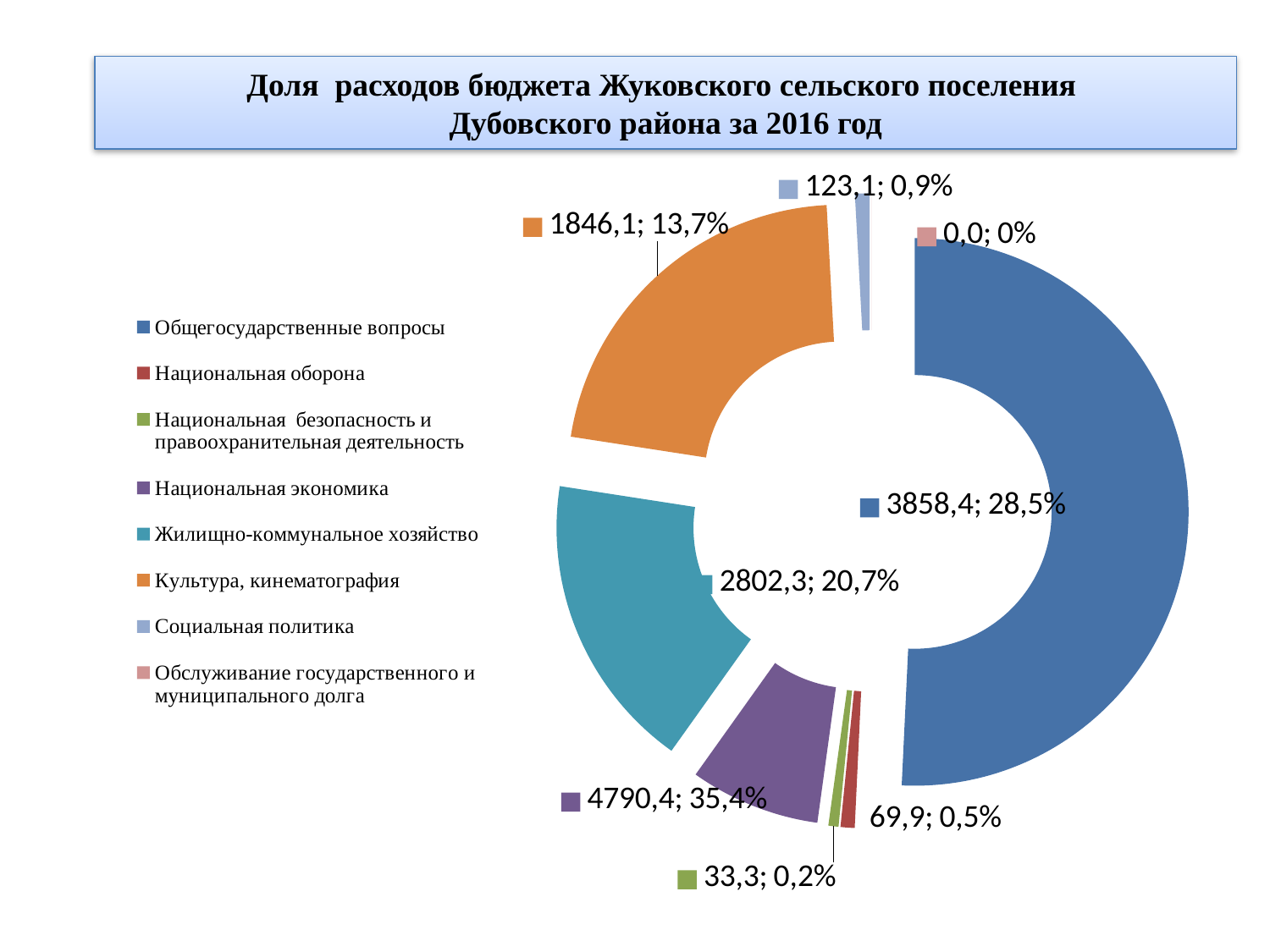
What is the difference between the values for Общегосударственные вопросы and Жилищно-коммунальное хозяйство? 1056,1 What kind of chart is shown on the slide? Pie (doughnut) chart Which is larger, the value for Культура, кинематография or for Социальная политика? Культура, кинематография What share is shown for Культура, кинематография? 13,7% How many categories does the legend list? 8 What value is shown for Социальная политика? 123,1 What share is shown for Национальная оборона? 0,5% Which category has the lowest value? Обслуживание государственного и муниципального долга What value is shown for Национальная безопасность и правоохранительная деятельность? 33,3 What share of the budget expenses is Общегосударственные вопросы? 28,5% What value is shown for Жилищно-коммунальное хозяйство? 2802,3 What value is shown for Общегосударственные вопросы? 3858,4